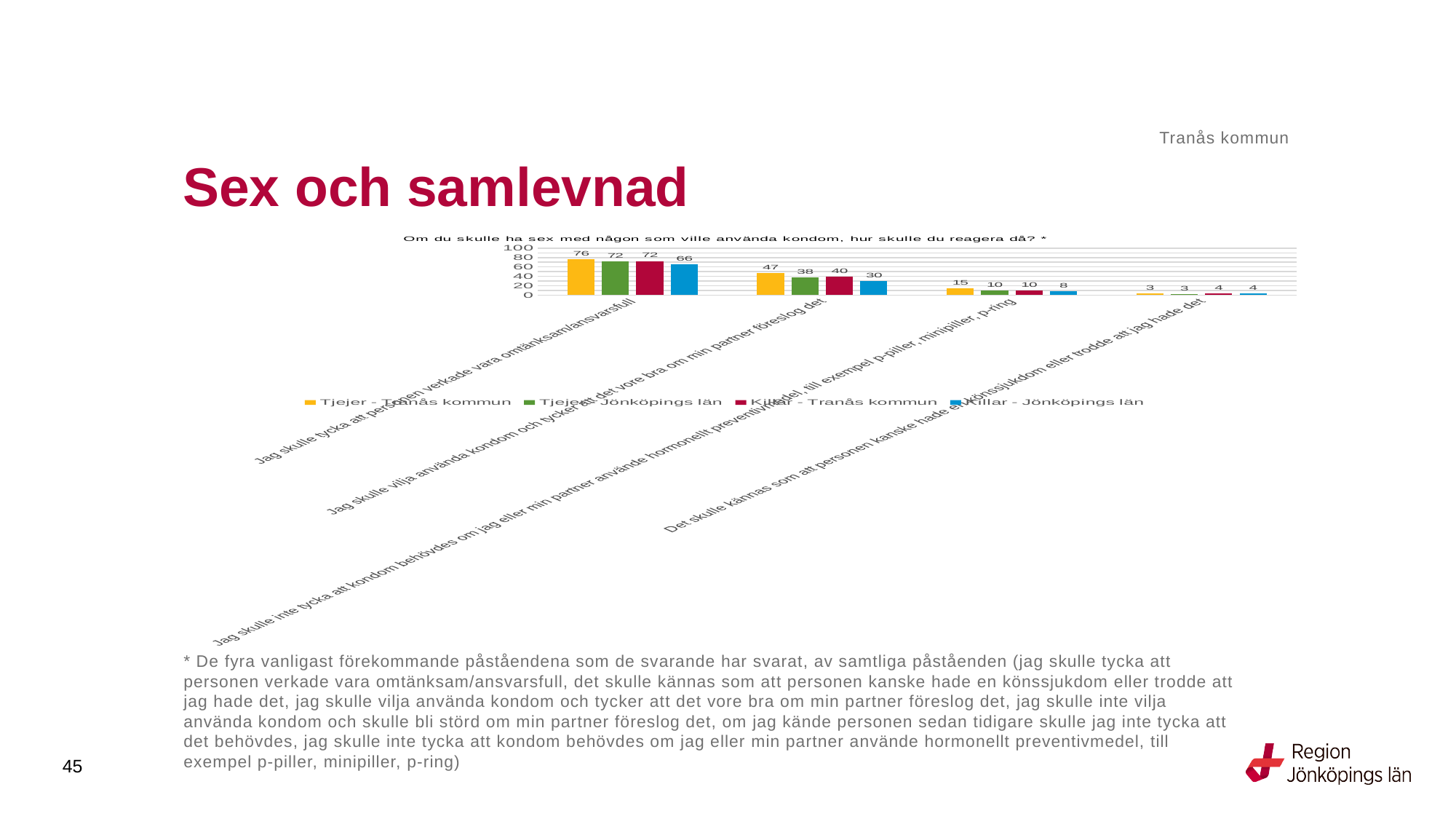
What is the difference between Tjejer - Tranås kommun and Killar - Jönköpings län in the category "Jag skulle tycka att personen verkade vara omtänksam/ansvarsfull"? 10 Which series has the lowest value in the category "Jag skulle tycka att personen verkade vara omtänksam/ansvarsfull"? Killar - Jönköpings län What is the value for Killar - Tranås kommun in the category "Det skulle kännas som att personen kanske hade en könssjukdom eller trodde att jag hade det"? 4 What is the value for Tjejer - Jönköpings län in the category "Jag skulle inte tycka att kondom behövdes om jag eller min partner använde hormonellt preventivmedel, till exempel p-piller, minipiller, p-ring"? 10 How many series does the legend list? 4 What is the value for Tjejer - Tranås kommun in the category "Jag skulle tycka att personen verkade vara omtänksam/ansvarsfull"? 76 Which is larger in the category "Jag skulle vilja använda kondom och tycker att det vore bra om min partner föreslog det": Tjejer - Jönköpings län or Killar - Tranås kommun? Killar - Tranås kommun Which series has the highest value in the category "Jag skulle vilja använda kondom och tycker att det vore bra om min partner föreslog det"? Tjejer - Tranås kommun Which colour represents Killar - Tranås kommun in the chart? Red How many categories are shown on the x axis of the chart? 4 What kind of chart is shown on the slide? Bar chart What is the value for Killar - Jönköpings län in the category "Jag skulle vilja använda kondom och tycker att det vore bra om min partner föreslog det"? 30